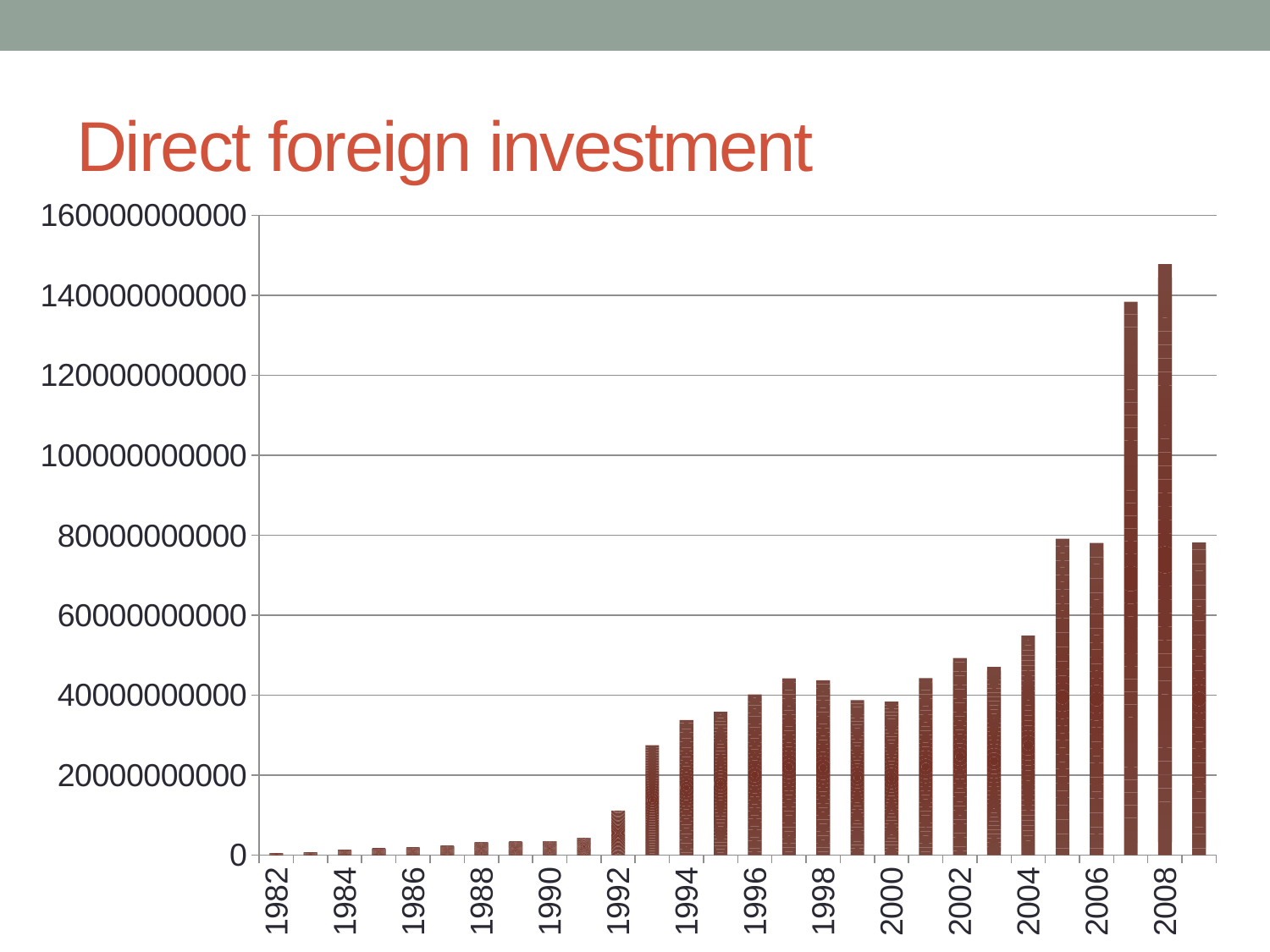
Which year has the lowest direct foreign investment? 1982 Is the value for 1992 greater or less than 20000000000? less Is the value for 2004 greater or less than 60000000000? less Which year has the larger value, 1992 or 1994? 1994 Which year has the larger value, 2006 or 2008? 2008 What kind of chart is shown on the slide? bar chart Do the values generally rise or fall from 1982 to 2008? rise Which year has the highest direct foreign investment? 2008 What is the title of the chart? Direct foreign investment Is the value for 2008 greater or less than 140000000000? greater